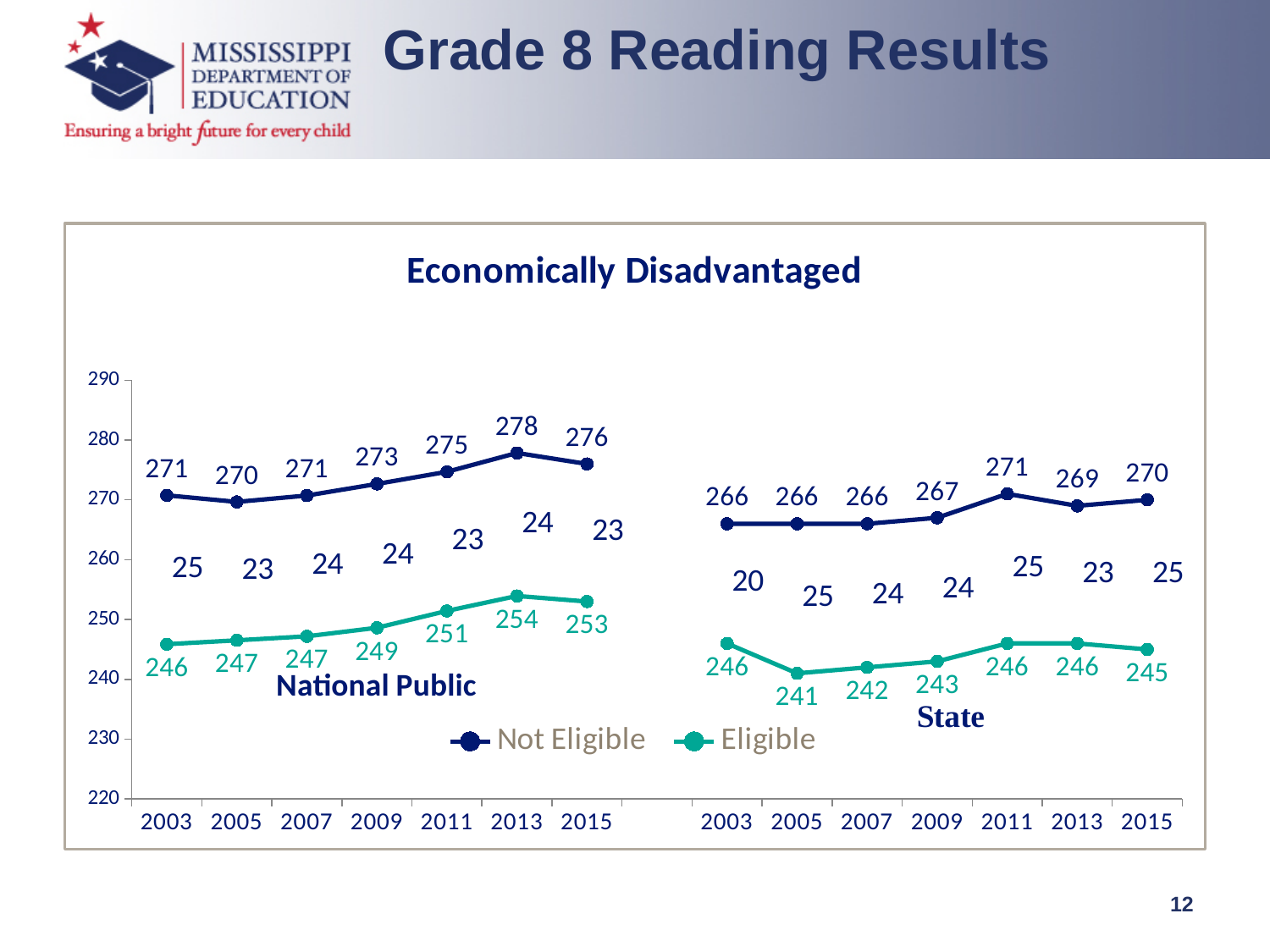
What is the Eligible value for National Public in 2015? 253 In which year is the Not Eligible value for National Public highest? 2013 Which is larger, the Not Eligible value for National Public in 2015 or the Not Eligible value for State in 2015? National Public (276) In which year is the Eligible value for State lowest? 2005 What is the title of the chart? Economically Disadvantaged What is the Not Eligible value for State in 2011? 271 What is the difference between the Not Eligible and Eligible values for State in 2003? 20 How many series does the legend list? 2 What is the Eligible value for State in 2005? 241 What is the Not Eligible value for National Public in 2013? 278 Which is larger, the Eligible value for National Public in 2003 or the Eligible value for State in 2003? They are equal (246) What kind of chart is shown on the slide? Line chart